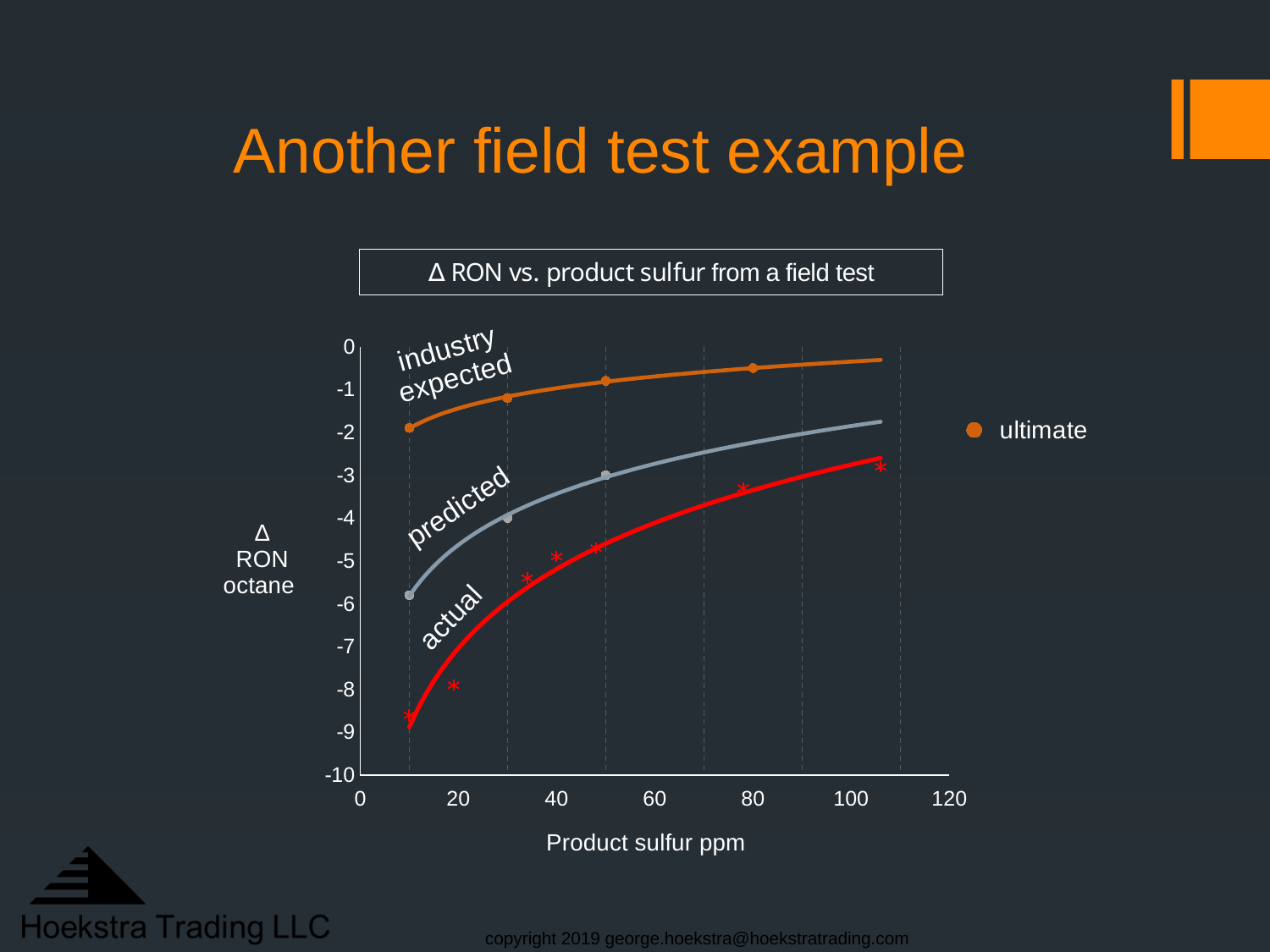
Is the actual Δ RON value at 10 ppm product sulfur greater or less than -8? less Is the predicted Δ RON value at 10 ppm product sulfur greater or less than -7? greater Which curve lies highest on the chart: industry expected, predicted, or actual? industry expected What is the title of the chart? Δ RON vs. product sulfur from a field test Do the Δ RON values rise or fall as product sulfur increases along the x axis? rise Is the industry expected Δ RON value at 10 ppm product sulfur greater or less than -3? greater How many entries does the legend list? 1 How many curves are plotted on the chart? 3 Which curve lies lowest on the chart: industry expected, predicted, or actual? actual What is the label of the x axis? Product sulfur ppm At 30 ppm product sulfur, which is larger: the industry expected Δ RON or the actual Δ RON? industry expected What kind of chart is shown on the slide? line chart